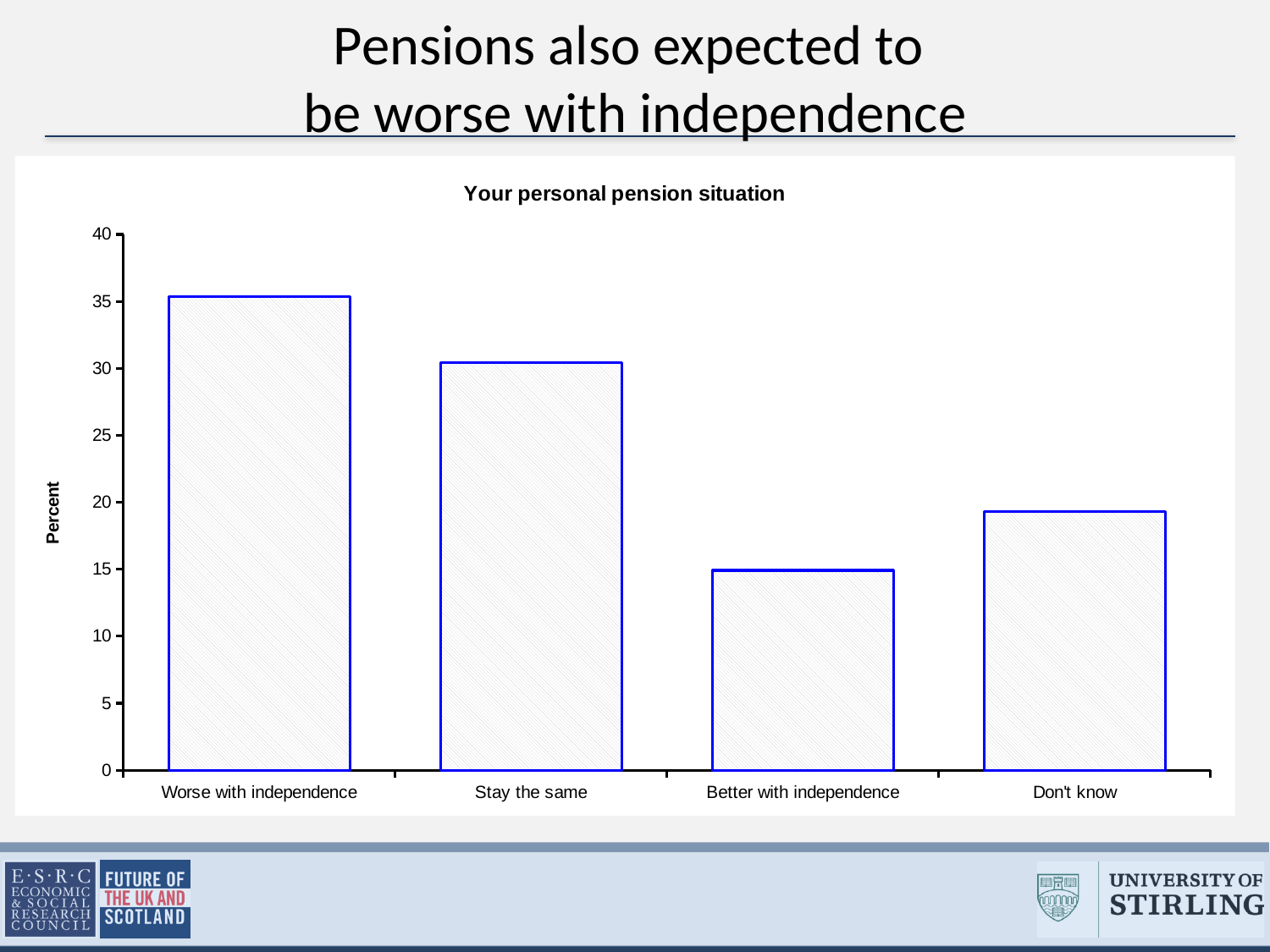
Is the value for Stay the same greater or less than 25? greater What is the label on the vertical axis of the chart? Percent What kind of chart is shown on the slide? bar chart Which is larger, the value for Don't know or the value for Better with independence? Don't know Which category has the highest value? Worse with independence Is the value for Better with independence greater or less than 20? less Is the value for Don't know greater or less than 15? greater Which is larger, the value for Stay the same or the value for Don't know? Stay the same What is the title of the chart? Your personal pension situation Which category has the lowest value? Better with independence How many categories are shown on the chart? 4